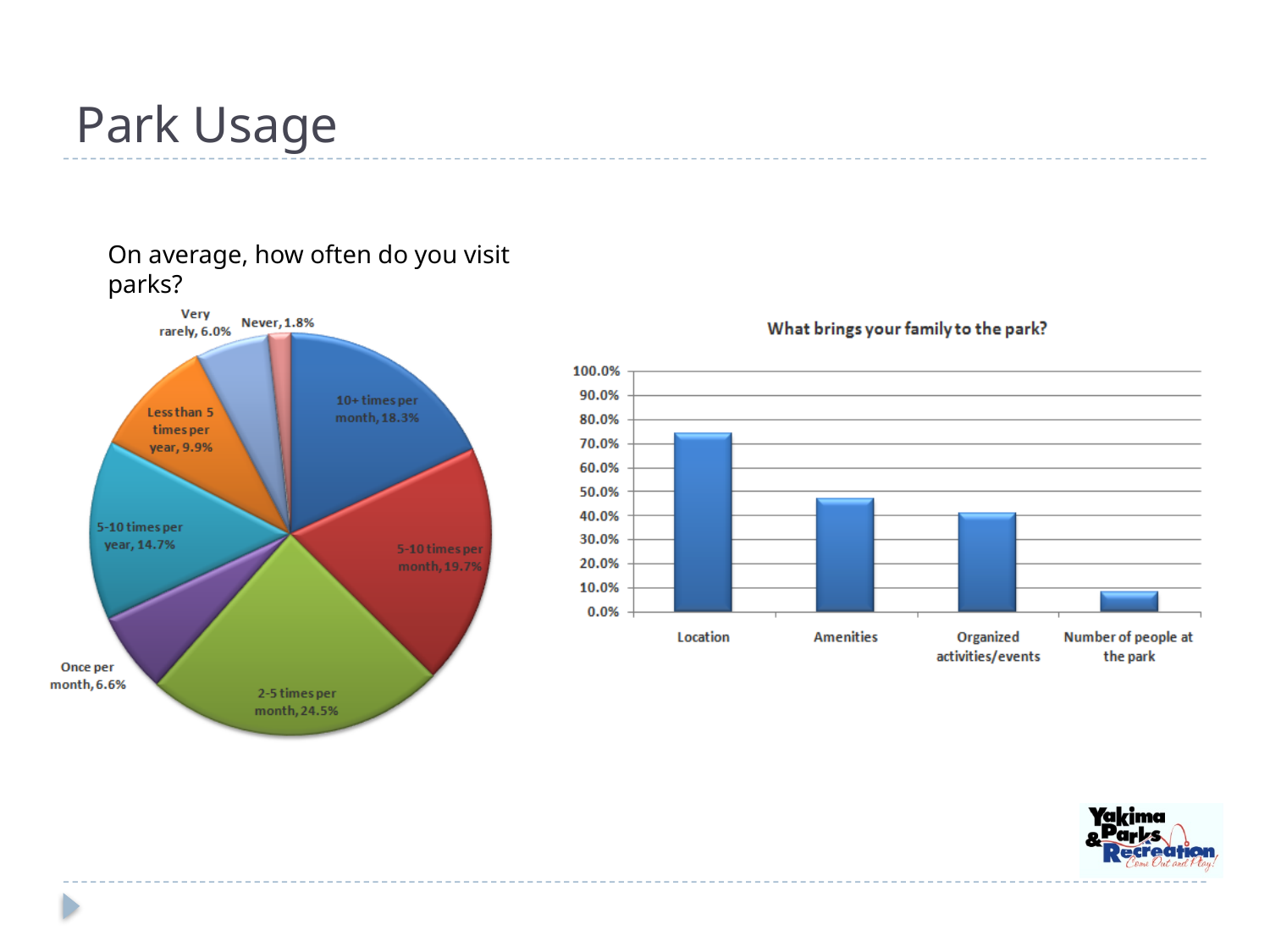
In the pie chart 'On average, how often do you visit parks?', which category has the smallest share? Never In the pie chart 'On average, how often do you visit parks?', what share of respondents visit 5-10 times per year? 14.7% In the bar chart 'What brings your family to the park?', which category has the highest value? Location In the bar chart 'What brings your family to the park?', is the value for 'Number of people at the park' greater or less than 10.0%? less In the pie chart 'On average, how often do you visit parks?', which is larger: 'Once per month' or 'Very rarely'? Once per month In the pie chart 'On average, how often do you visit parks?', what share of respondents answered 'Never'? 1.8% In the pie chart 'On average, how often do you visit parks?', which category has the largest share? 2-5 times per month What kind of chart is 'What brings your family to the park?'? Bar chart In the pie chart 'On average, how often do you visit parks?', what is the difference between the shares for '5-10 times per month' and '10+ times per month'? 1.4% How many slices does the pie chart 'On average, how often do you visit parks?' have? 8 In the bar chart 'What brings your family to the park?', is the value for Location greater or less than 70.0%? greater In the pie chart 'On average, how often do you visit parks?', what share of respondents visit 2-5 times per month? 24.5%